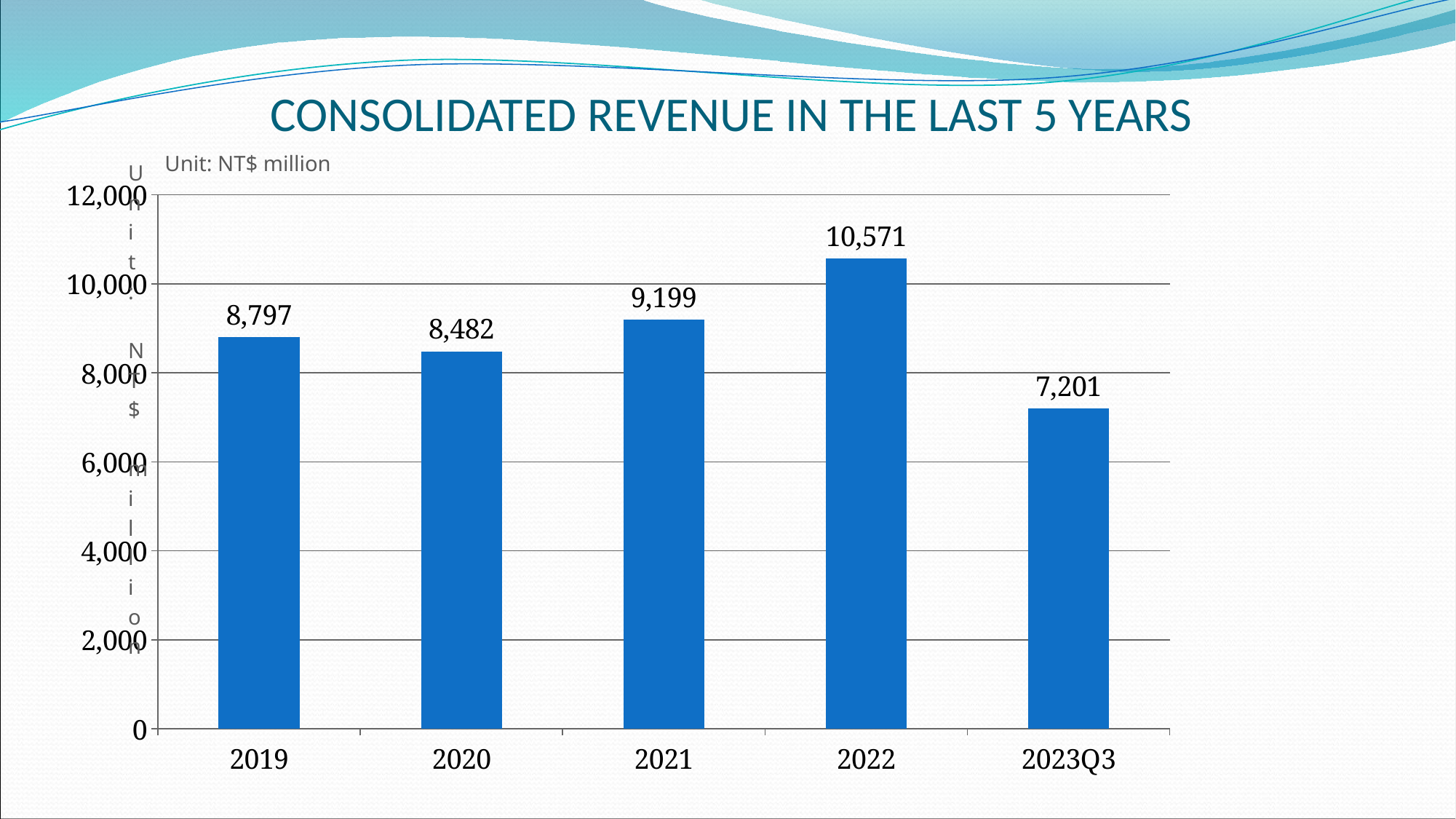
Does the revenue rise or fall from 2020 to 2022? rise What is the consolidated revenue for 2022? 10,571 What is the consolidated revenue for 2019? 8,797 Which category has the lowest consolidated revenue? 2023Q3 What unit is stated for the values in the chart? NT$ million What is the consolidated revenue for 2023Q3? 7,201 What kind of chart is shown on the slide? bar chart Is the value for 2021 greater or less than 10,000? less What is the difference between the revenue in 2022 and the revenue in 2021? 1,372 How many categories are shown on the x axis? 5 Which is larger, the revenue for 2019 or the revenue for 2020? 2019 Which year has the highest consolidated revenue? 2022